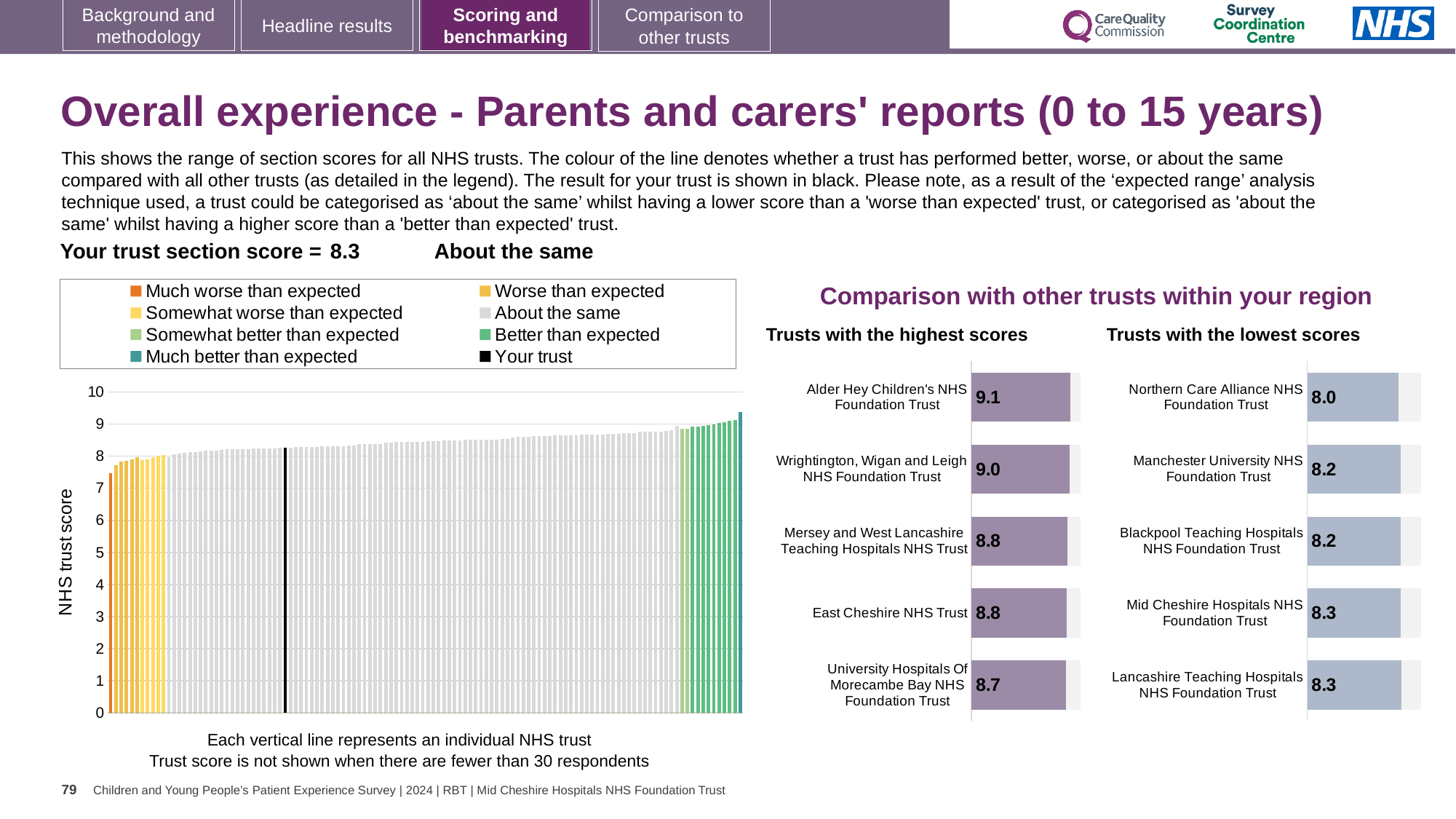
In the 'Trusts with the lowest scores' chart, what is the score for Northern Care Alliance NHS Foundation Trust? 8.0 In the chart on the left showing the range of NHS trust scores, do the values rise or fall from left to right? Rise In the 'Trusts with the highest scores' chart, which has the higher score: Wrightington, Wigan and Leigh NHS Foundation Trust or Mersey and West Lancashire Teaching Hospitals NHS Trust? Wrightington, Wigan and Leigh NHS Foundation Trust In the chart on the left, is the value for the black 'Your trust' line greater or less than 5? greater In the 'Trusts with the highest scores' chart, what is the difference between the scores of Alder Hey Children's NHS Foundation Trust and University Hospitals Of Morecambe Bay NHS Foundation Trust? 0.4 In the 'Trusts with the highest scores' chart, which trust has the highest score? Alder Hey Children's NHS Foundation Trust What kind of chart is the chart on the left showing the range of NHS trust scores? Bar chart How many entries does the legend above the left-hand chart list? 8 In the 'Trusts with the lowest scores' chart, which trust has the lowest score? Northern Care Alliance NHS Foundation Trust In the 'Trusts with the lowest scores' chart, what is the score for Mid Cheshire Hospitals NHS Foundation Trust? 8.3 In the 'Trusts with the highest scores' chart, what is the score for Alder Hey Children's NHS Foundation Trust? 9.1 How many trusts are shown in the 'Trusts with the lowest scores' chart? 5